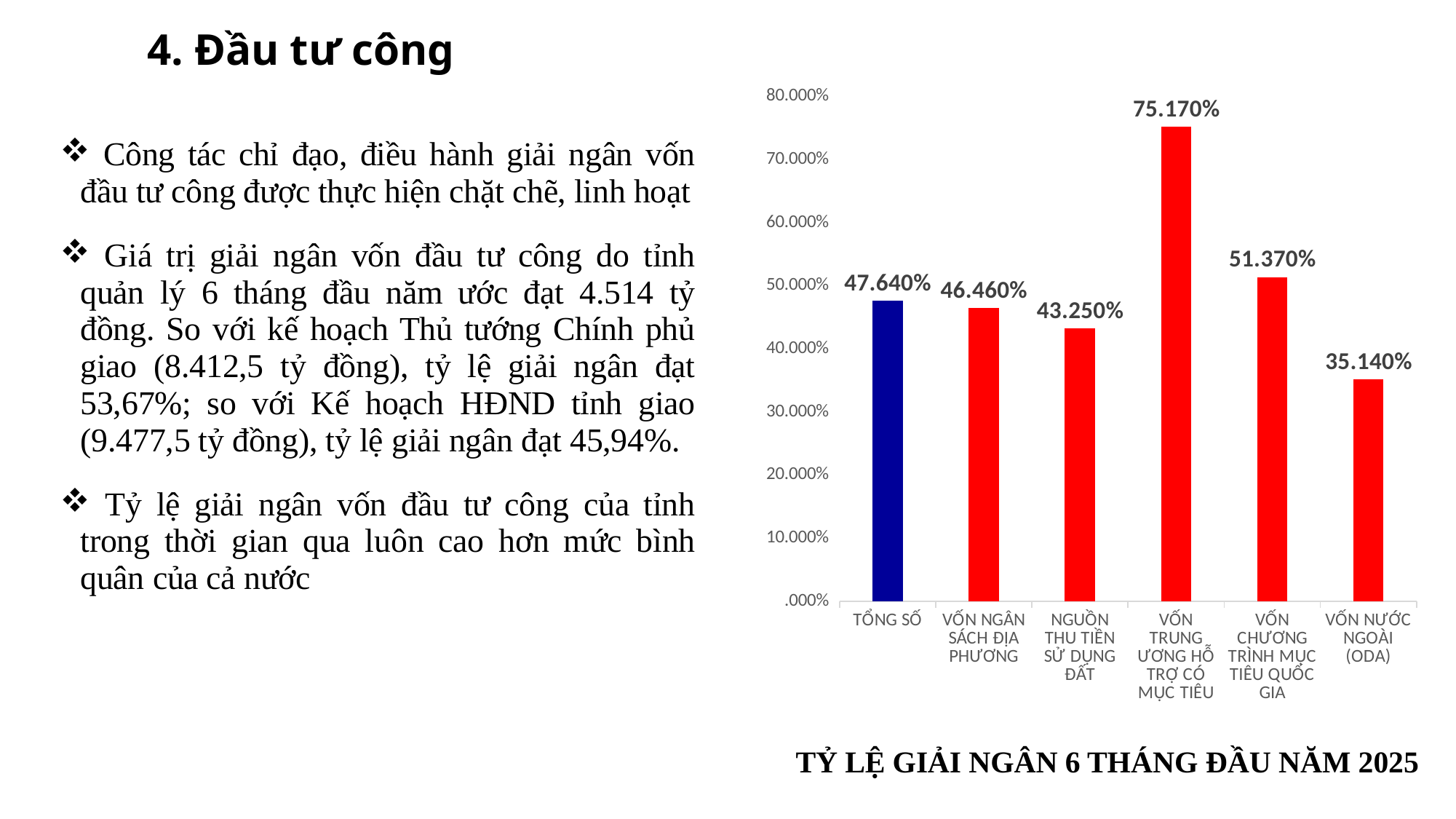
What is the value for VỐN CHƯƠNG TRÌNH MỤC TIÊU QUỐC GIA? 51.370% What is the value for NGUỒN THU TIỀN SỬ DỤNG ĐẤT? 43.250% Is the value for VỐN TRUNG ƯƠNG HỖ TRỢ CÓ MỤC TIÊU greater or less than 70.000%? greater Which category has the highest value? VỐN TRUNG ƯƠNG HỖ TRỢ CÓ MỤC TIÊU What is the difference between the values for VỐN TRUNG ƯƠNG HỖ TRỢ CÓ MỤC TIÊU and VỐN NƯỚC NGOÀI (ODA)? 40.030% What type of chart is shown on the slide? Bar chart Which category has the lowest value? VỐN NƯỚC NGOÀI (ODA) What is the difference between the values for VỐN CHƯƠNG TRÌNH MỤC TIÊU QUỐC GIA and TỔNG SỐ? 3.730% What is the value for TỔNG SỐ? 47.640% How many categories are shown in the chart? 6 Which is larger, the value for VỐN NGÂN SÁCH ĐỊA PHƯƠNG or the value for NGUỒN THU TIỀN SỬ DỤNG ĐẤT? VỐN NGÂN SÁCH ĐỊA PHƯƠNG What is the value for VỐN NƯỚC NGOÀI (ODA)? 35.140%